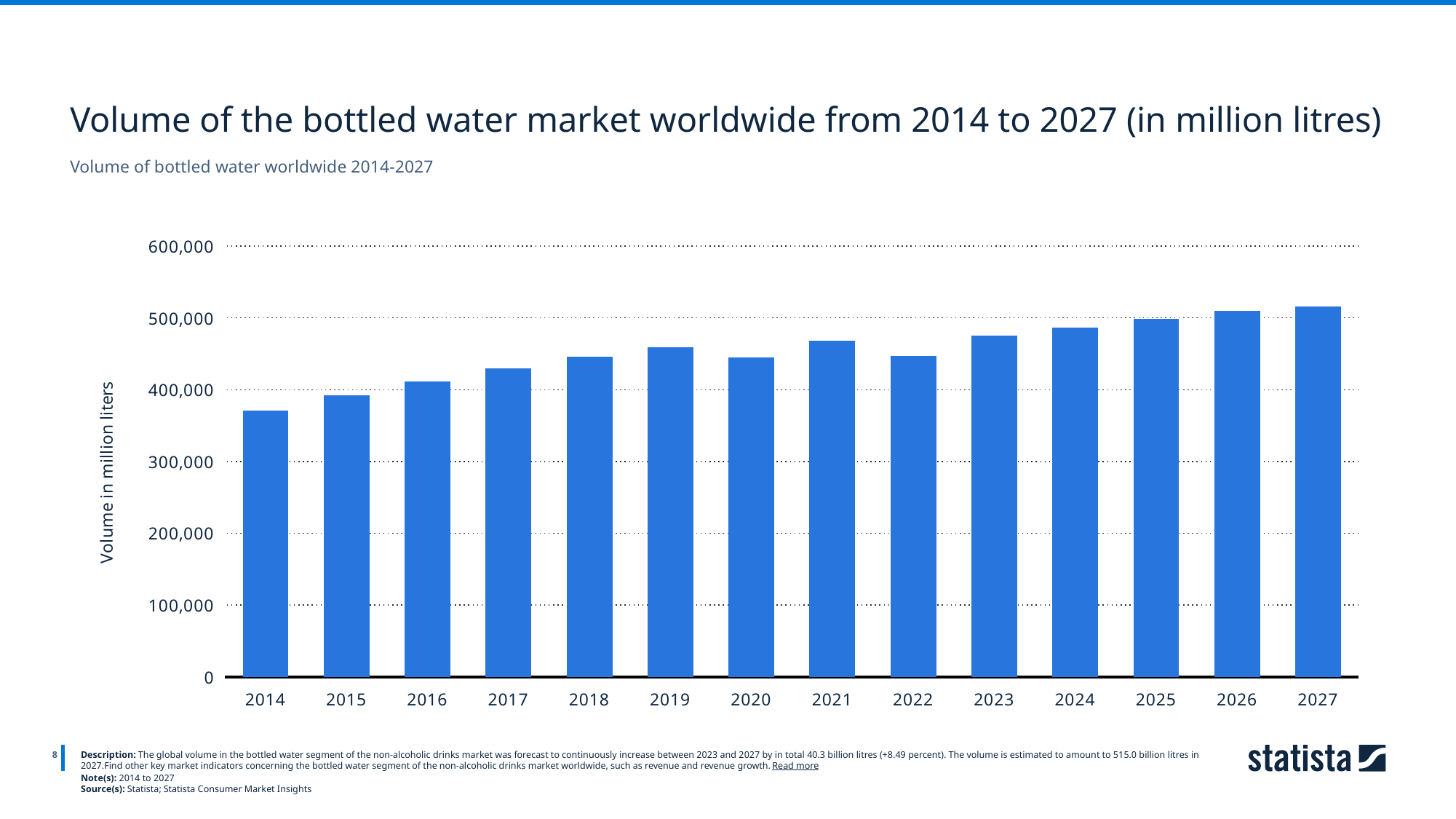
Which year has the larger volume, 2021 or 2022? 2021 Is the value for 2027 greater or less than 500,000? greater Which year has the highest bottled water volume? 2027 How many years are plotted on the chart? 14 Which year has the larger volume, 2016 or 2020? 2020 Is the value for 2016 greater or less than 400,000? greater Is the value for 2014 greater or less than 400,000? less What is the label on the vertical axis? Volume in million liters What kind of chart is shown on the slide? Bar chart Do the values generally rise or fall from 2014 to 2027? Rise Which year has the lowest bottled water volume? 2014